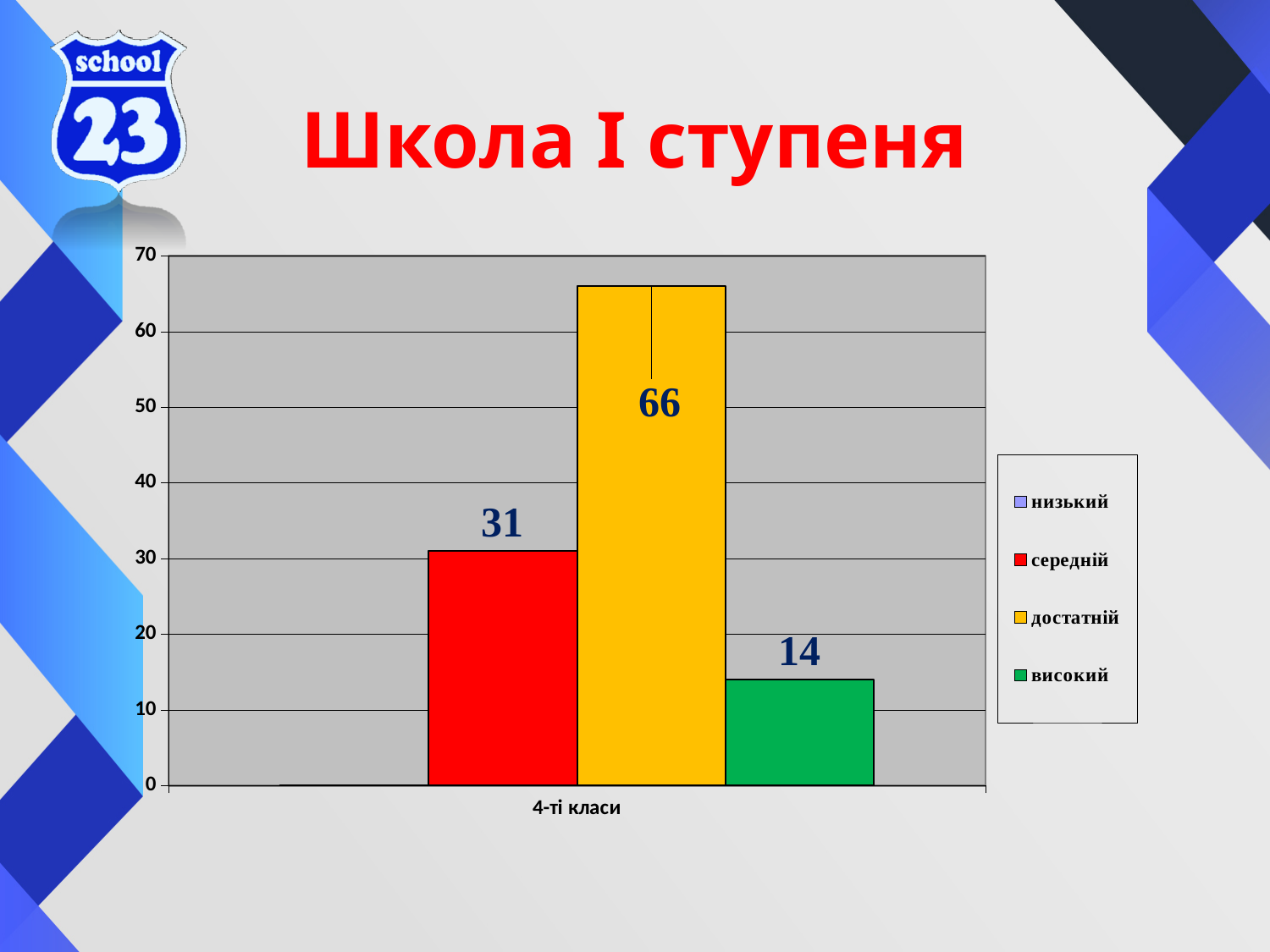
What is the value for достатній in the 4-ті класи category? 66 What kind of chart is shown on the slide? bar chart What is the value for середній in the 4-ті класи category? 31 How many series does the legend list? 4 What is the value for високий in the 4-ті класи category? 14 What is the title of the slide above the chart? Школа І ступеня What is the difference between the середній and високий values? 17 Among the series with labelled bars, which has the lowest value? високий Which is larger, the value for середній or the value for високий? середній Is the value for достатній greater or less than 60? greater Which series has the highest value for 4-ті класи? достатній What is the difference between the достатній and середній values? 35